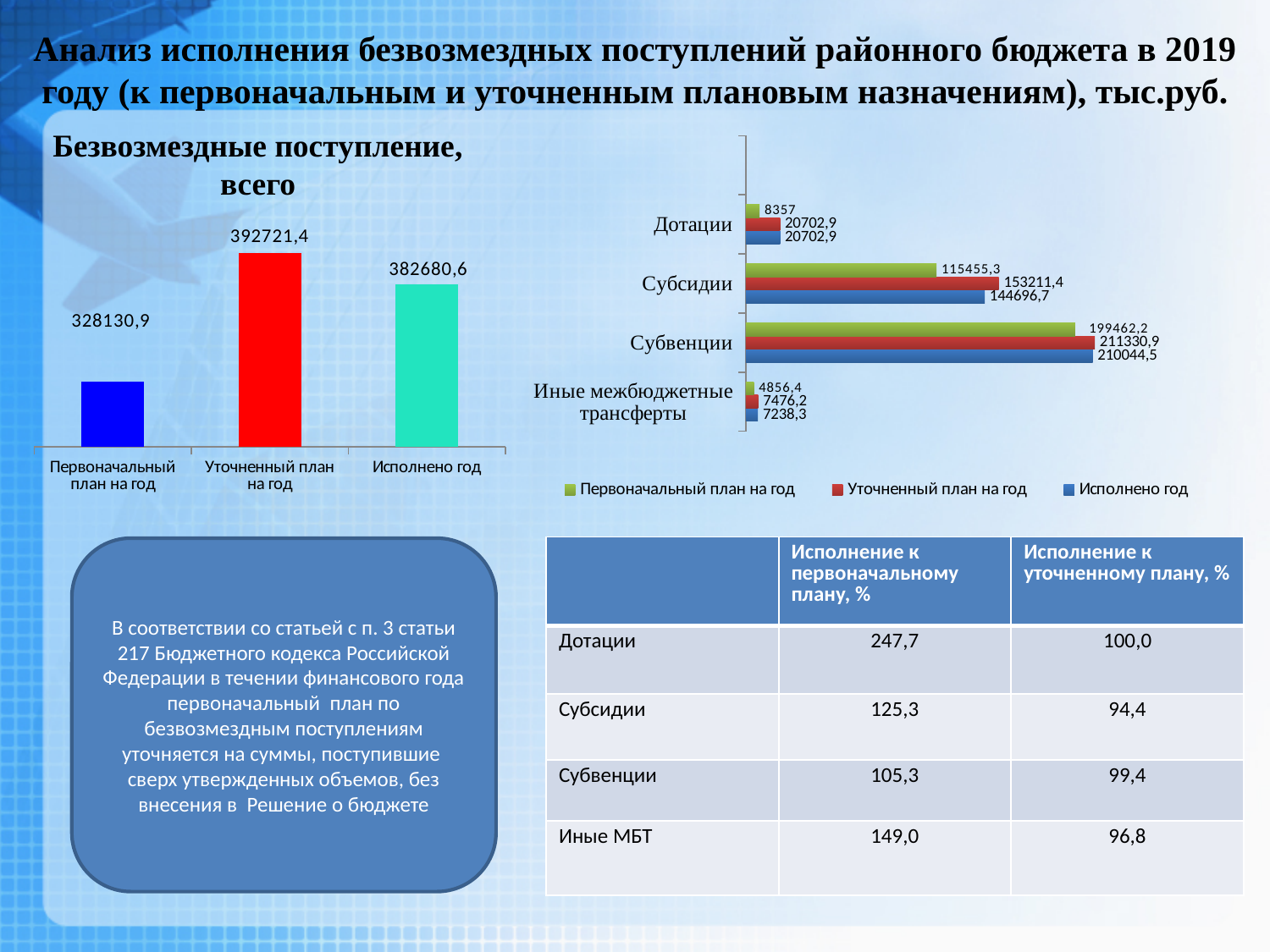
In the right-hand chart, which category has the highest 'Уточненный план на год' value? Субвенции In the right-hand chart, what is the value of 'Исполнено год' for 'Субсидии'? 144696,7 In the right-hand chart, what is the value of 'Первоначальный план на год' for 'Дотации'? 8357 In the right-hand chart, what is the value of 'Исполнено год' for 'Иные межбюджетные трансферты'? 7238,3 In the chart 'Безвозмездные поступление, всего', what is the value for 'Уточненный план на год'? 392721,4 In the chart 'Безвозмездные поступление, всего', what is the difference between 'Уточненный план на год' and 'Исполнено год'? 10040,8 In the chart 'Безвозмездные поступление, всего', which category has the lowest value? Первоначальный план на год In the right-hand chart, what is the difference between 'Уточненный план на год' and 'Исполнено год' for 'Субвенции'? 1286,4 In the right-hand chart, which is larger for 'Субсидии': 'Уточненный план на год' or 'Исполнено год'? Уточненный план на год What kind of chart is 'Безвозмездные поступление, всего'? bar chart How many series does the legend of the right-hand chart list? 3 In the chart 'Безвозмездные поступление, всего', how many bars are plotted? 3